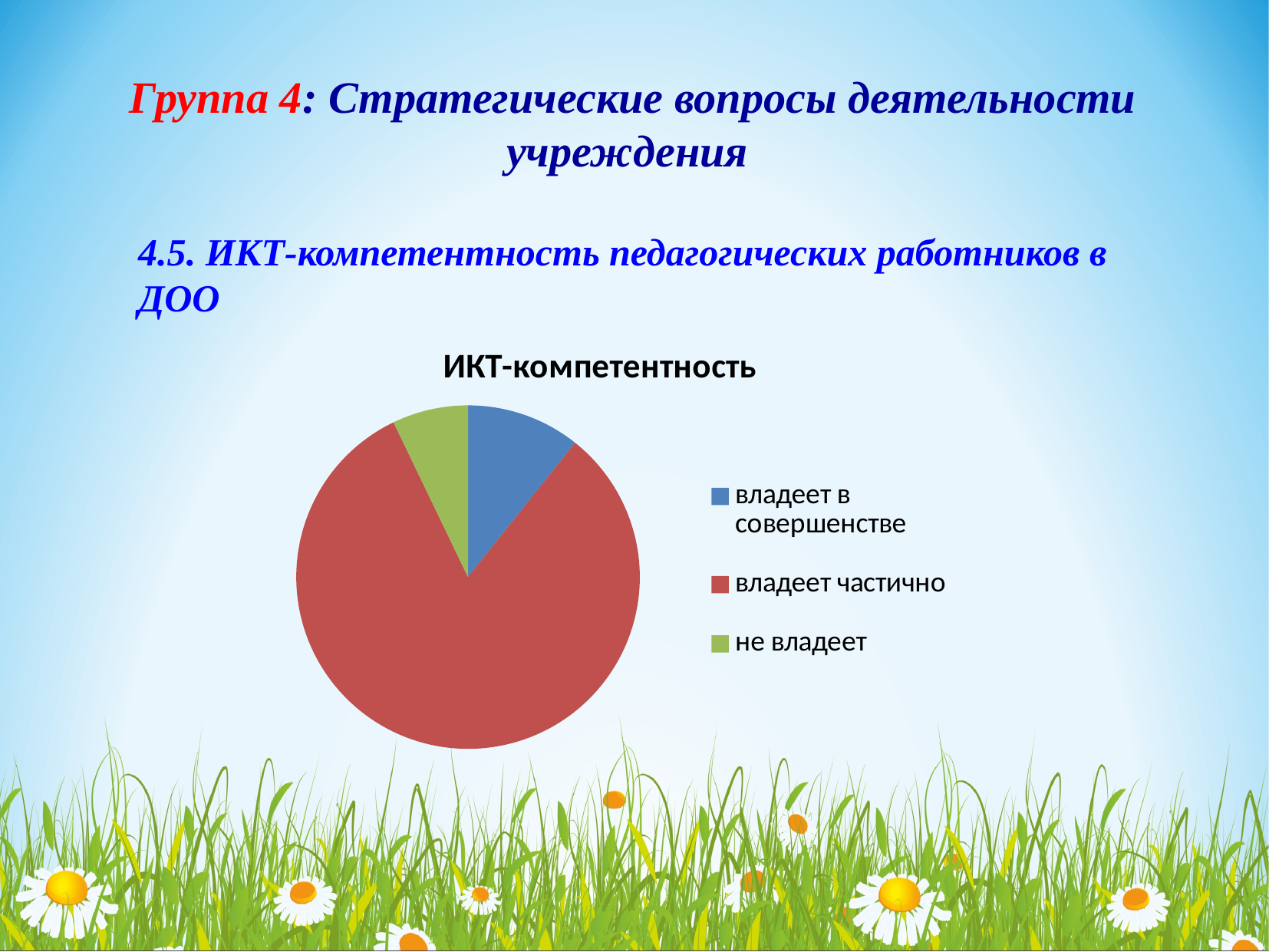
What is the title of the chart? ИКТ-компетентность Which category has the largest slice of the pie? владеет частично Which category has the smallest slice of the pie? не владеет How many entries does the legend list? 3 What kind of chart is shown on the slide? pie chart Does the 'владеет частично' slice take up more or less than half of the pie? more Which slice is larger: 'владеет в совершенстве' or 'не владеет'? владеет в совершенстве How many slices does the pie chart have? 3 Which slice is larger: 'владеет частично' or 'владеет в совершенстве'? владеет частично What colour is the slice for 'владеет частично'? red